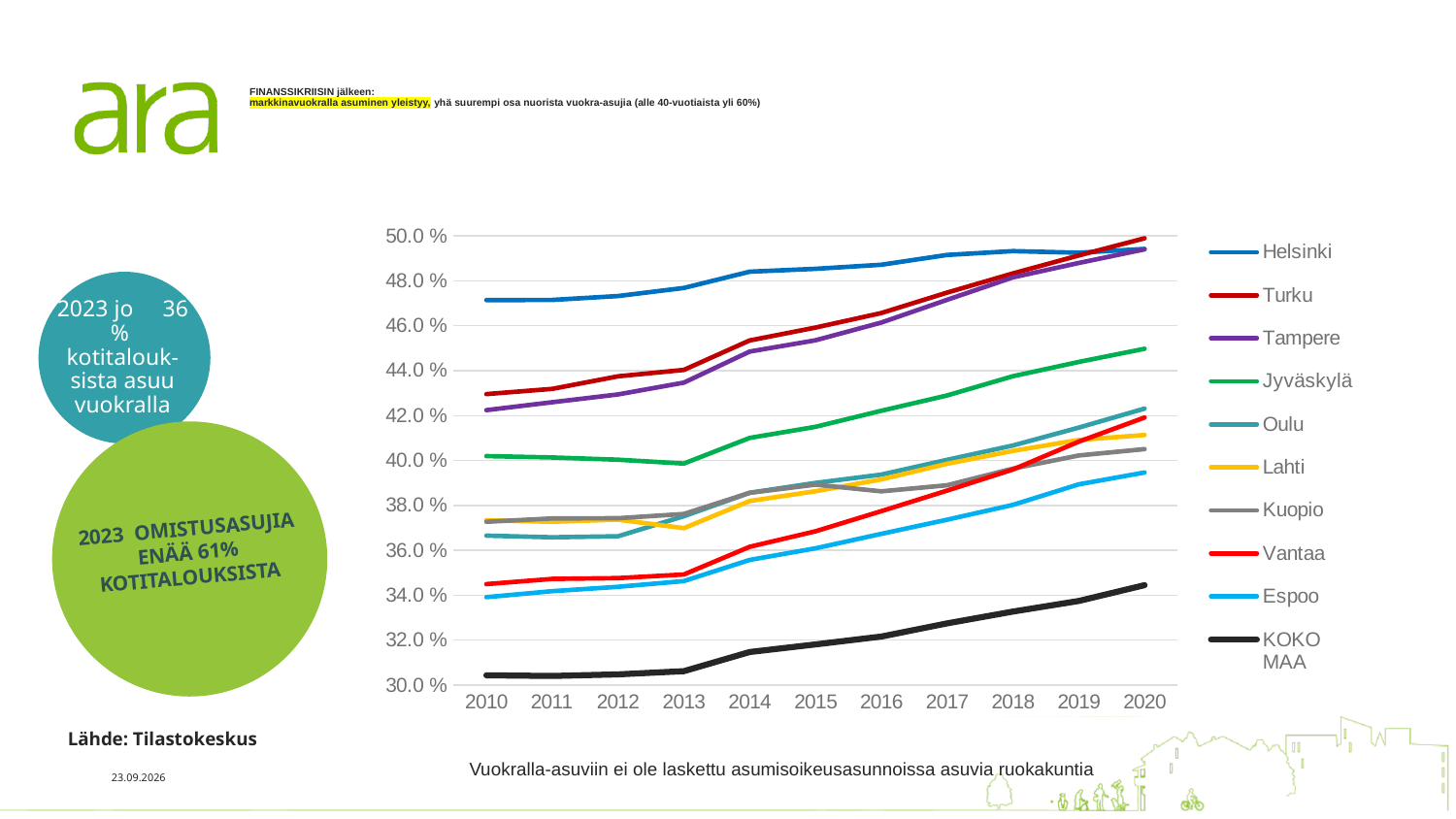
Does the value for KOKO MAA rise or fall from 2010 to 2020? rise Is the value for KOKO MAA in 2020 greater or less than 36.0 %? less In 2020, which is larger, the value for Vantaa or the value for Espoo? Vantaa Is the value for Jyväskylä in 2020 greater or less than 44.0 %? greater How many series does the legend list? 10 Which series has the lowest value in 2020? KOKO MAA Is the value for Helsinki in 2010 greater or less than 46.0 %? greater What is the highest value shown on the y axis? 50.0 % What kind of chart is shown on the slide? line chart How many years are shown along the x axis? 11 Which series has the highest value in 2010? Helsinki